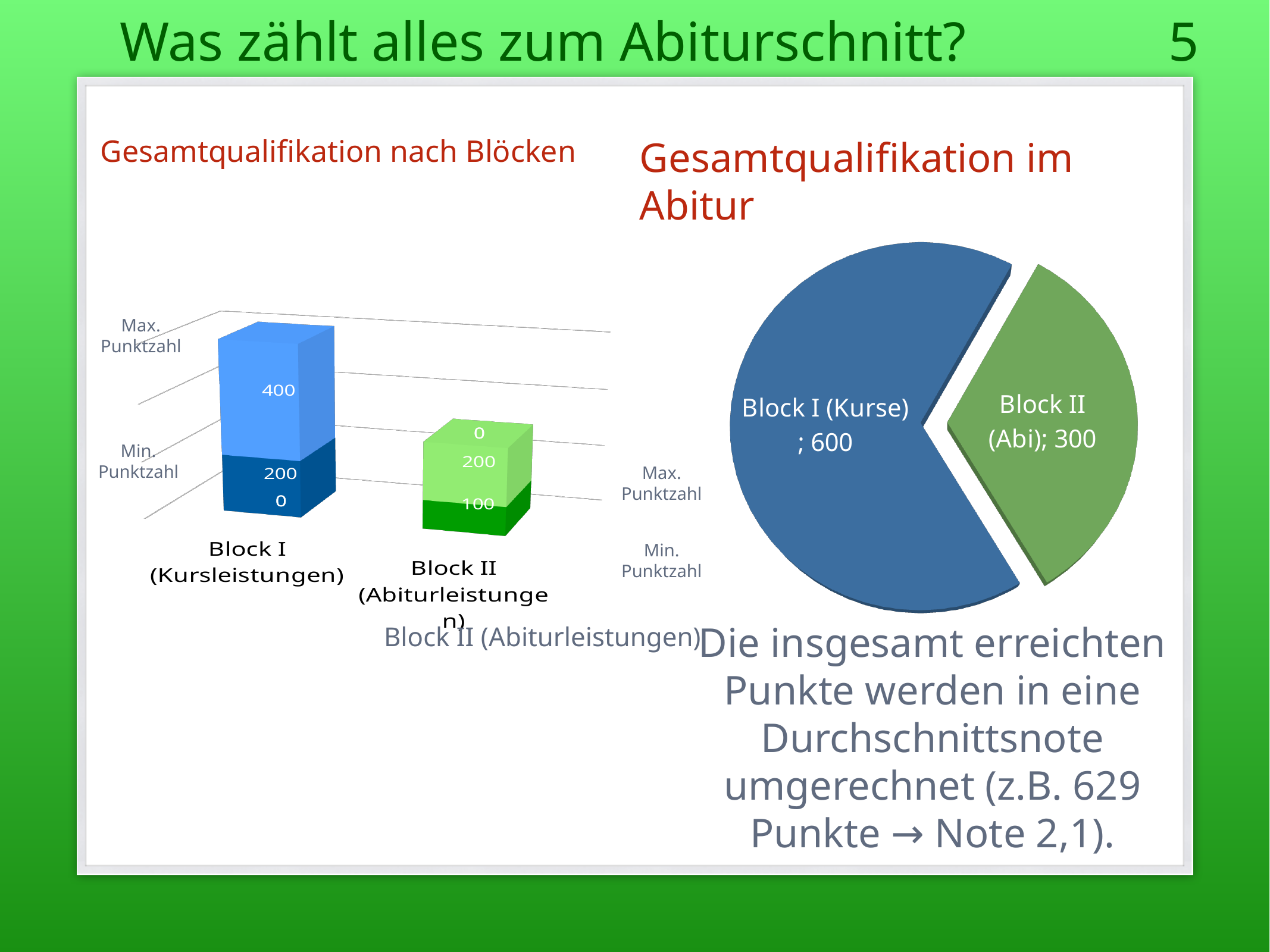
What kind of chart is 'Gesamtqualifikation im Abitur'? Pie chart What kind of chart is 'Gesamtqualifikation nach Blöcken'? Stacked bar chart In the pie chart 'Gesamtqualifikation im Abitur', which slice is the smallest? Block II (Abi) In the pie chart 'Gesamtqualifikation im Abitur', what value is shown for Block I (Kurse)? 600 In the chart 'Gesamtqualifikation nach Blöcken', what is the value of the dark green (lower) segment of the Block II (Abiturleistungen) bar? 100 In the pie chart 'Gesamtqualifikation im Abitur', which slice is the largest? Block I (Kurse) In the pie chart 'Gesamtqualifikation im Abitur', what value is shown for Block II (Abi)? 300 In the chart 'Gesamtqualifikation nach Blöcken', which bar is taller, Block I (Kursleistungen) or Block II (Abiturleistungen)? Block I (Kursleistungen) In the pie chart 'Gesamtqualifikation im Abitur', what is the difference between the Block I (Kurse) value and the Block II (Abi) value? 300 In the chart 'Gesamtqualifikation nach Blöcken', what is the value of the light blue (upper) segment of the Block I (Kursleistungen) bar? 400 In the pie chart 'Gesamtqualifikation im Abitur', how many slices are there? 2 In the chart 'Gesamtqualifikation nach Blöcken', how many categories are shown on the x axis? 2